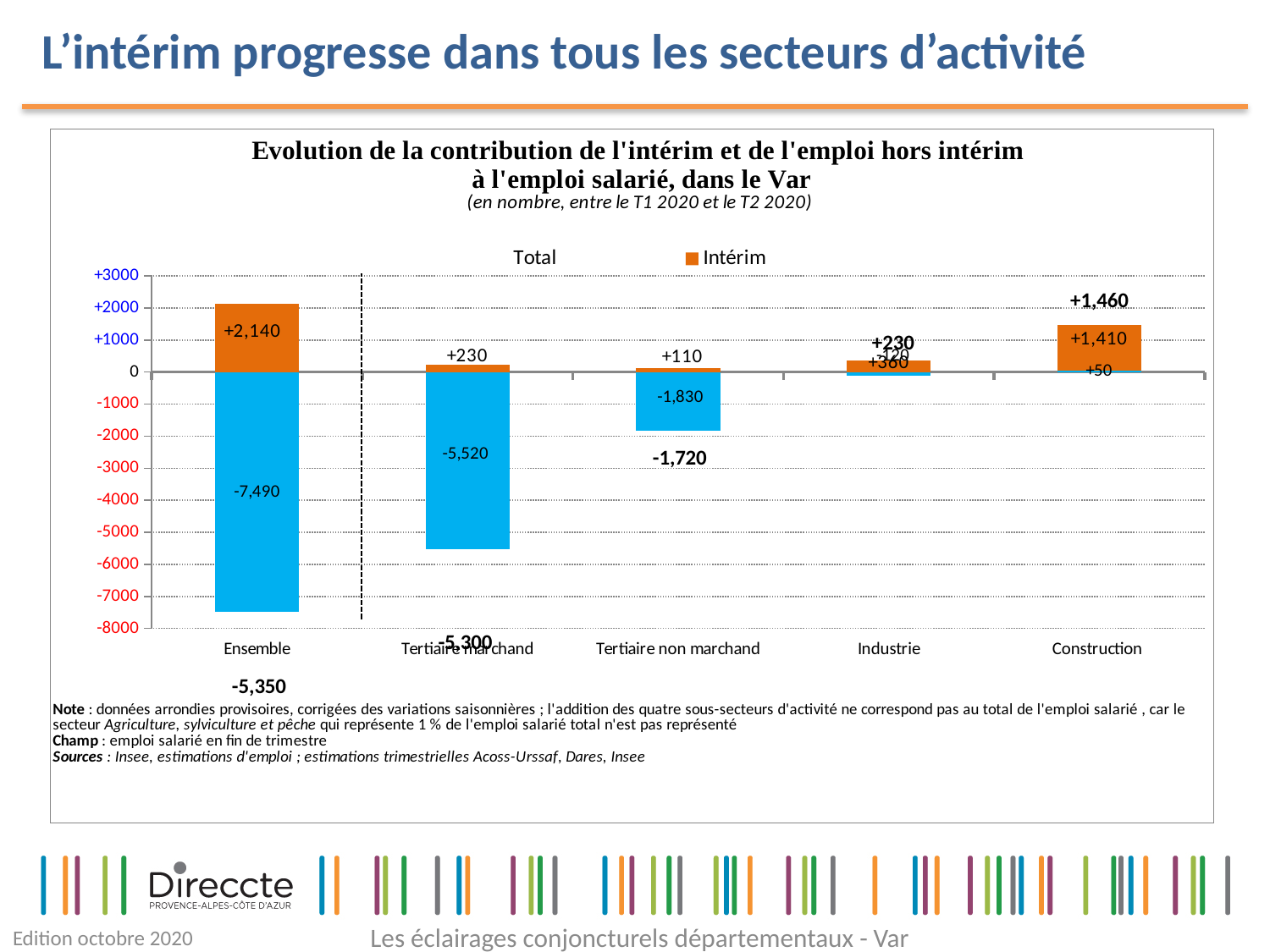
What is the value of the blue (hors intérim) segment for Tertiaire non marchand? -1,830 What is the total shown for Ensemble? -5,350 What is the Intérim value for Tertiaire marchand? +230 What is the total shown for Construction? +1,460 What is the Intérim value for Tertiaire non marchand? +110 Is the Intérim value for Ensemble larger or smaller than the Intérim value for Construction? larger What type of chart is shown on the slide? bar chart Which category has the largest Intérim value? Ensemble What is the value of the blue (hors intérim) segment for Ensemble? -7,490 Which category has the lowest blue (hors intérim) value? Ensemble What is the Intérim value for Ensemble? +2,140 What is the Intérim value for Construction? +1,410